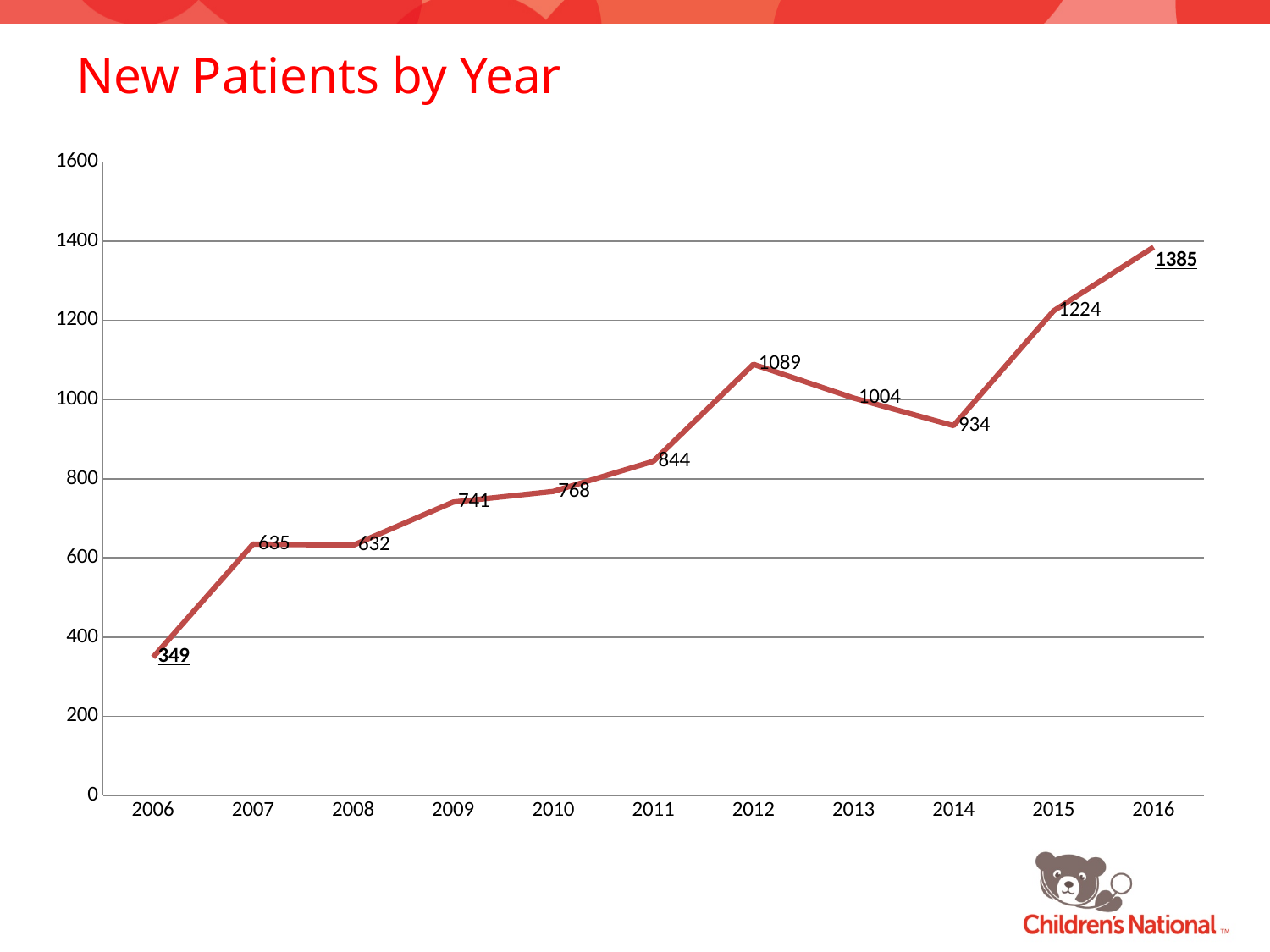
What is the title of the chart? New Patients by Year What kind of chart is shown on the slide? line chart What is the difference between the values for 2016 and 2006? 1036 Which year has the lowest number of new patients? 2006 What is the value for 2014? 934 Which is larger, the value for 2013 or the value for 2014? 2013 What is the difference between the values for 2012 and 2013? 85 How many years are plotted on the chart? 11 What is the value for 2012? 1089 Which year has the highest number of new patients? 2016 Is the value for 2015 greater or less than 1200? greater What is the value for 2006? 349